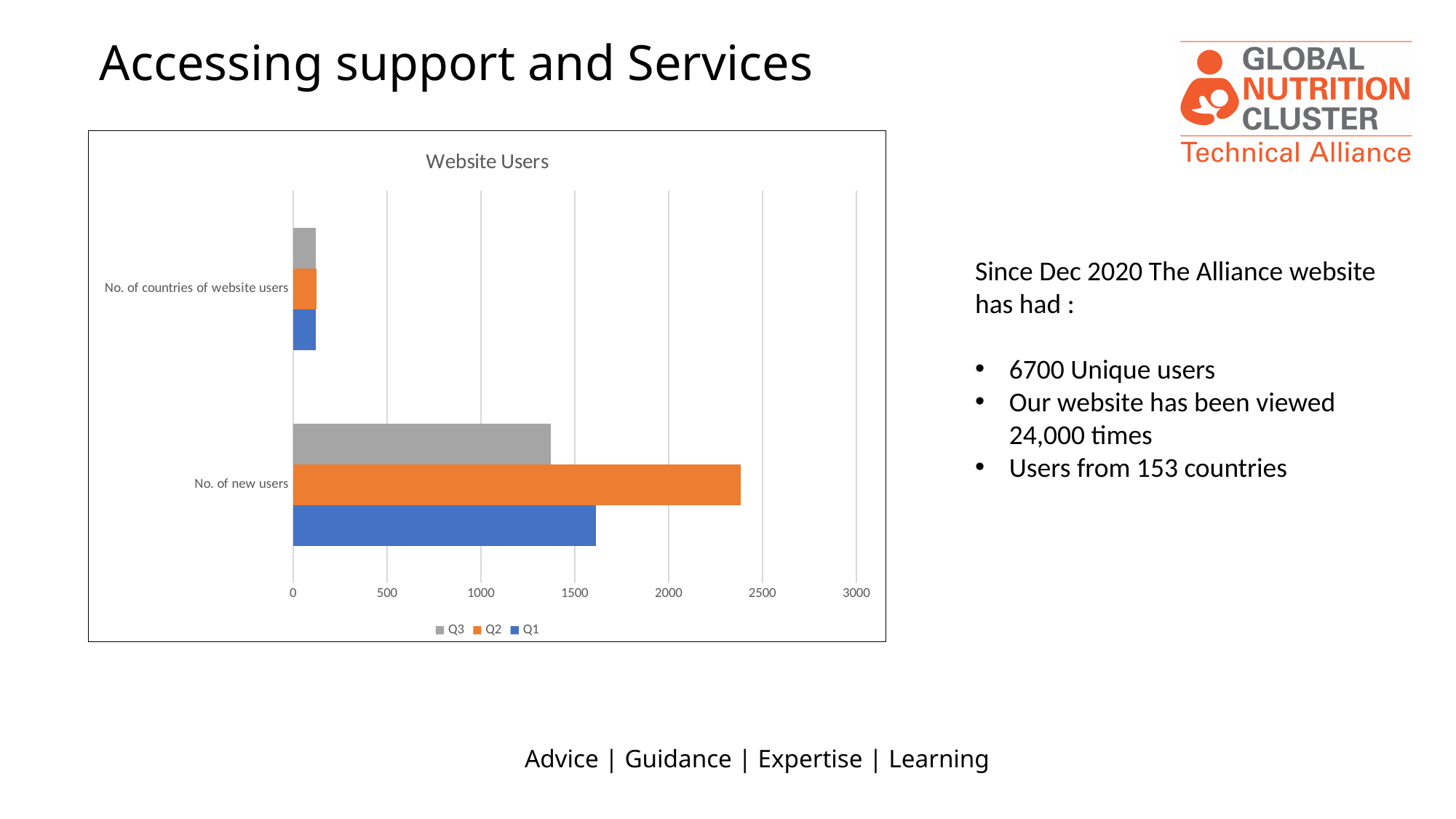
How many series does the chart legend list? 3 Is the Q3 value for No. of new users greater or less than 1500? less For No. of new users, is the Q1 value larger or the Q3 value larger? Q1 Is the Q2 value for No. of new users greater or less than 2000? greater What kind of chart is shown on the slide? Bar chart Is the Q2 value for No. of countries of website users greater or less than 500? less What is the title of the chart? Website Users Which quarter has the lowest value for No. of new users? Q3 Which colour represents the Q2 series in the chart? Orange Which quarter has the highest value for No. of new users? Q2 How many categories are shown on the chart's vertical axis? 2